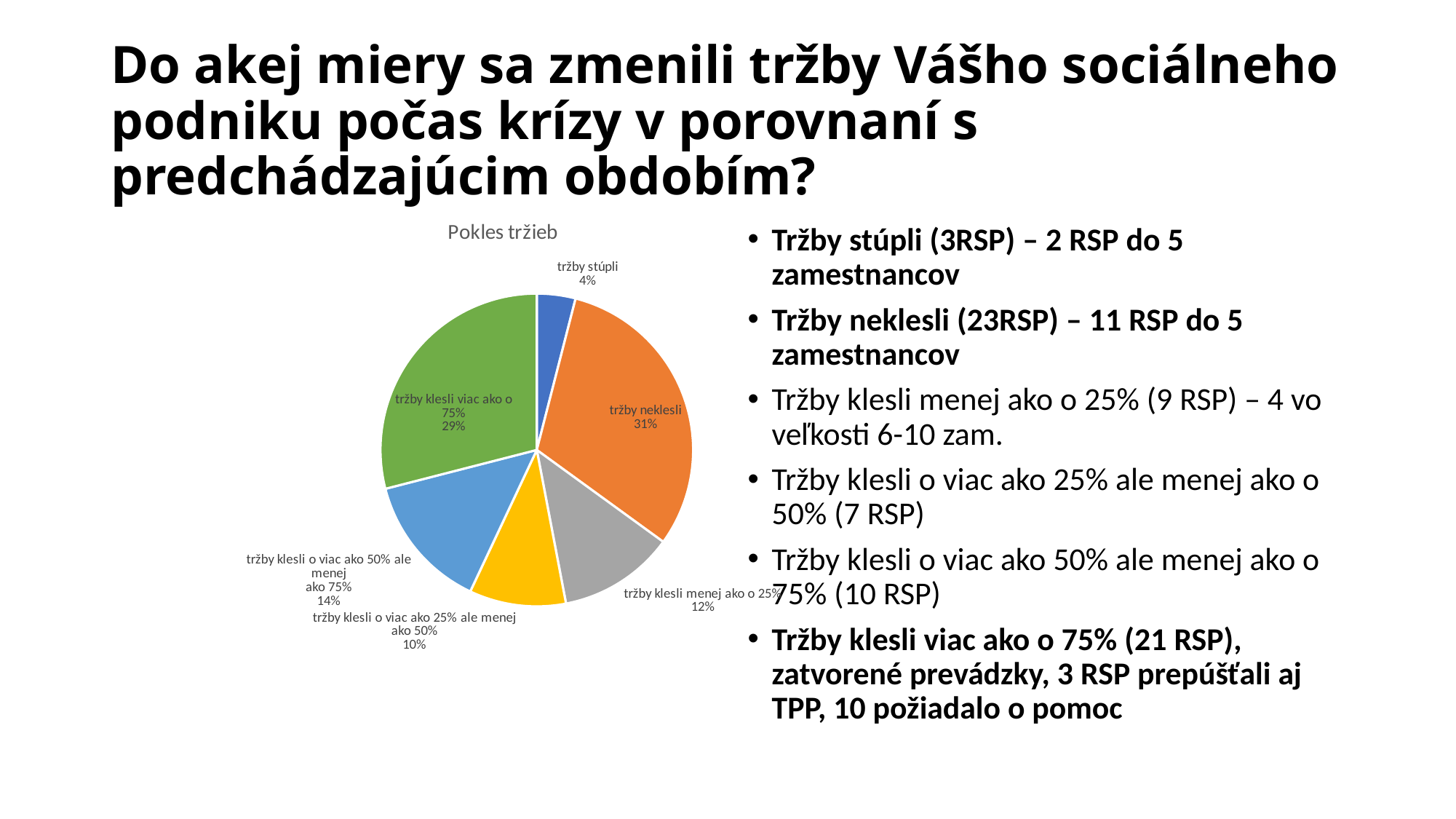
How many slices does the pie chart have? 6 Which slice of the pie chart is the largest? tržby neklesli What share of the pie is labelled "tržby klesli o viac ako 50% ale menej ako 75%"? 14% Which slice is larger: "tržby klesli o viac ako 25% ale menej ako 50%" or "tržby klesli o viac ako 50% ale menej ako 75%"? tržby klesli o viac ako 50% ale menej ako 75% What share of the pie is labelled "tržby klesli menej ako o 25%"? 12% What share of the pie is labelled "tržby stúpli"? 4% What is the difference in percentage points between the "tržby neklesli" slice and the "tržby klesli viac ako o 75%" slice? 2 percentage points What type of chart is shown on the slide? pie chart What is the title of the chart? Pokles tržieb Which slice of the pie chart is the smallest? tržby stúpli